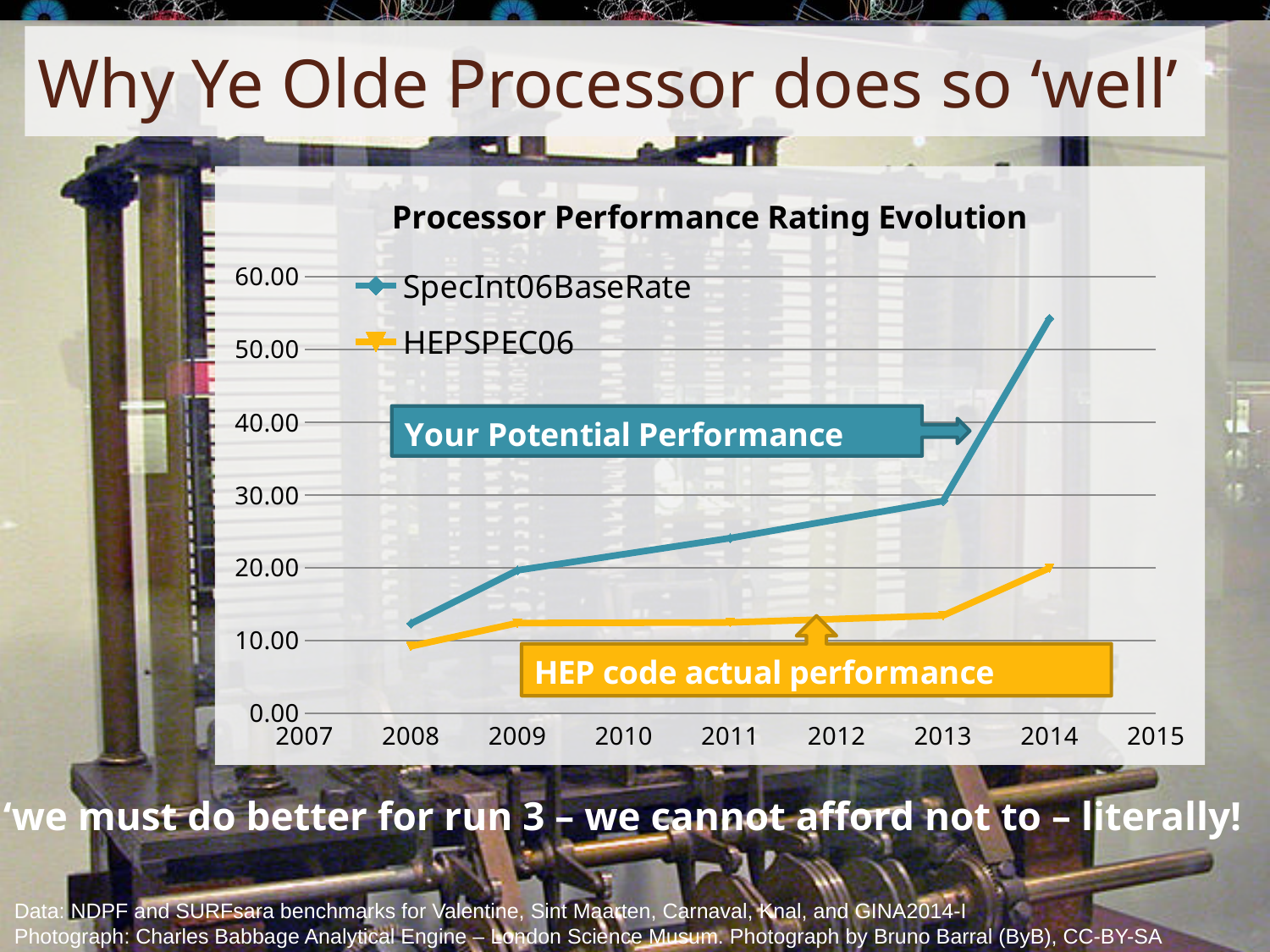
In which year does the SpecInt06BaseRate series reach its highest value? 2014 Which series is drawn in yellow? HEPSPEC06 In 2014, which series has the larger value, SpecInt06BaseRate or HEPSPEC06? SpecInt06BaseRate How many series does the chart legend list? 2 How many data points are plotted for the SpecInt06BaseRate series? 5 What type of chart is shown on the slide? line chart What is the title of the chart? Processor Performance Rating Evolution Is the SpecInt06BaseRate value for 2014 greater or less than 50.00? greater In which year is the HEPSPEC06 series at its lowest value? 2008 Is the HEPSPEC06 value for 2008 greater or less than 10.00? less Is the SpecInt06BaseRate value for 2011 greater or less than 20.00? greater Does the SpecInt06BaseRate series rise or fall from 2008 to 2014? rise